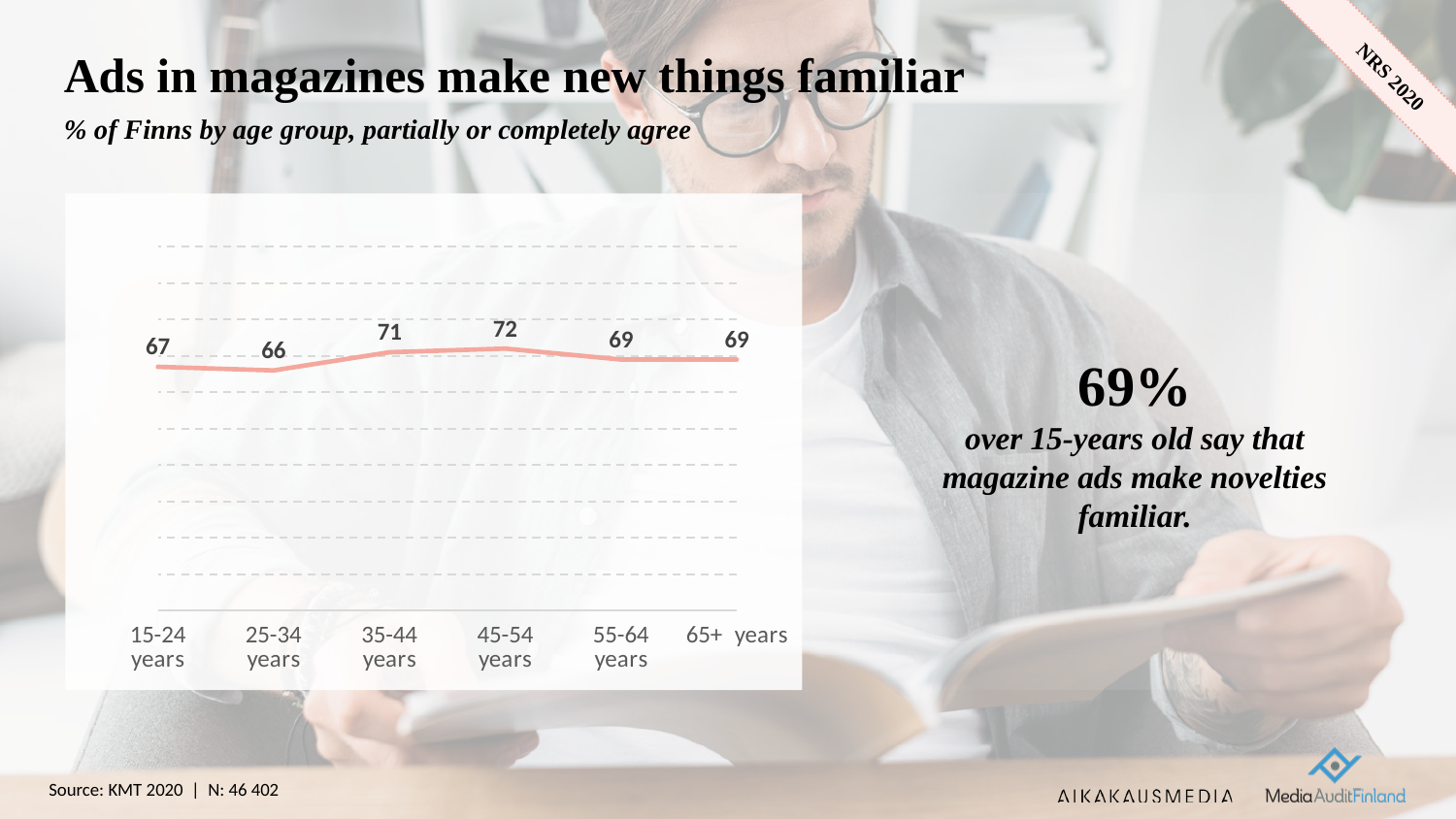
How many age groups are plotted on the chart? 6 Does the value rise or fall from 25-34 years to 45-54 years? Rise Which age group has the highest value? 45-54 years Which age group has the lowest value? 25-34 years What is the value for the 45-54 years age group? 72 What is the value for the 65+ years age group? 69 What is the title of the chart? Ads in magazines make new things familiar Which is larger, the value for 35-44 years or the value for 15-24 years? 35-44 years What is the difference between the values for 55-64 years and 65+ years? 0 What is the difference between the values for 45-54 years and 25-34 years? 6 What kind of chart is shown on the slide? Line chart What is the value for the 15-24 years age group? 67